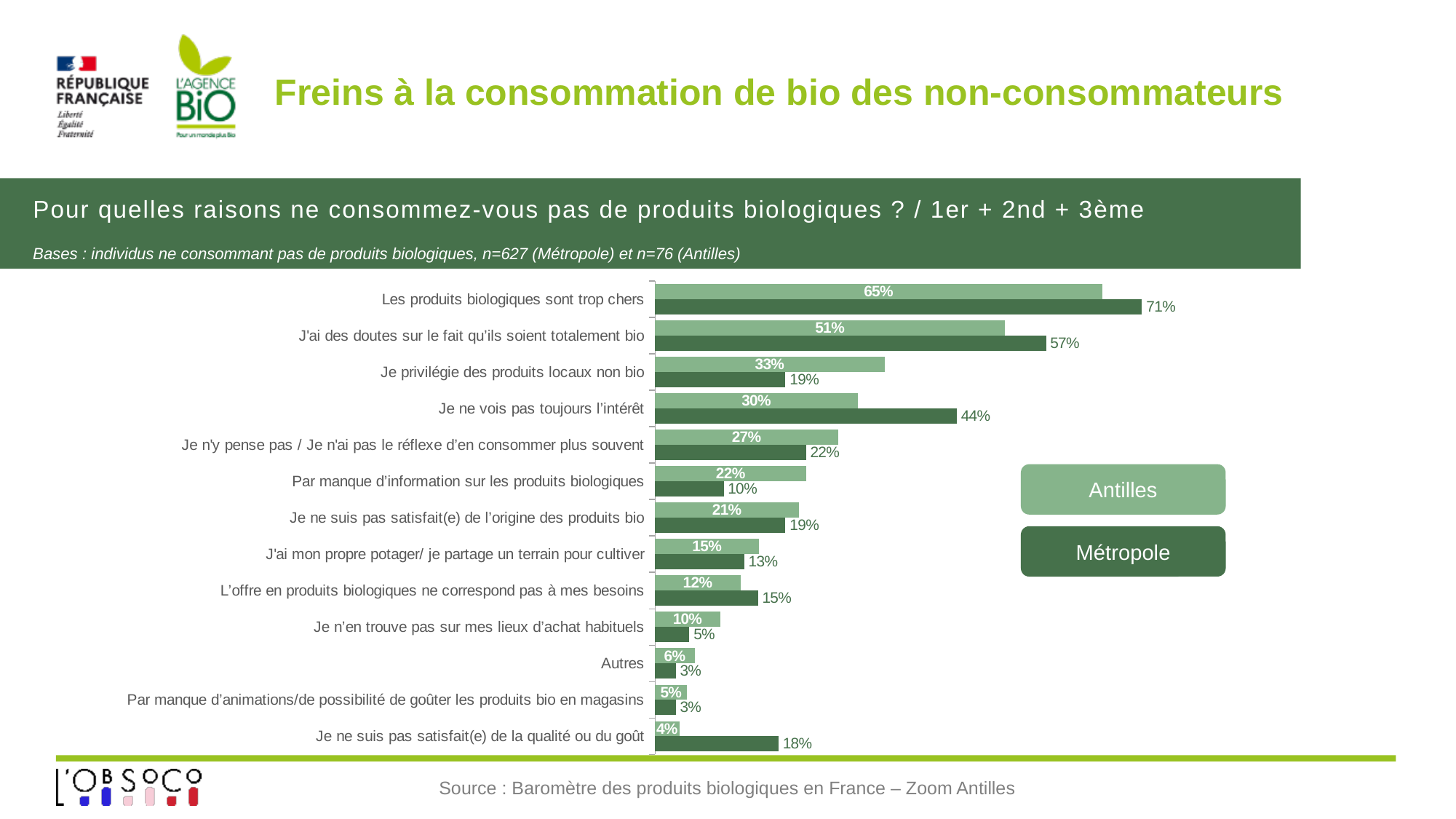
Which series is shown in the darker green colour? Métropole How many series does the legend list? 2 What type of chart is shown on the slide? bar chart What is the Antilles value for "Je privilégie des produits locaux non bio"? 33% What is the Métropole value for "Les produits biologiques sont trop chers"? 71% What is the Antilles value for "Je n'en trouve pas sur mes lieux d'achat habituels"? 10% What is the Métropole value for "Je ne suis pas satisfait(e) de la qualité ou du goût"? 18% How many categories (reasons) are plotted in the chart? 13 What is the difference between the Métropole and Antilles values for "Je ne vois pas toujours l'intérêt"? 14% For "Par manque d'information sur les produits biologiques", which series has the larger value, Antilles or Métropole? Antilles Which category has the highest Antilles value? Les produits biologiques sont trop chers Which category has the lowest Antilles value? Je ne suis pas satisfait(e) de la qualité ou du goût